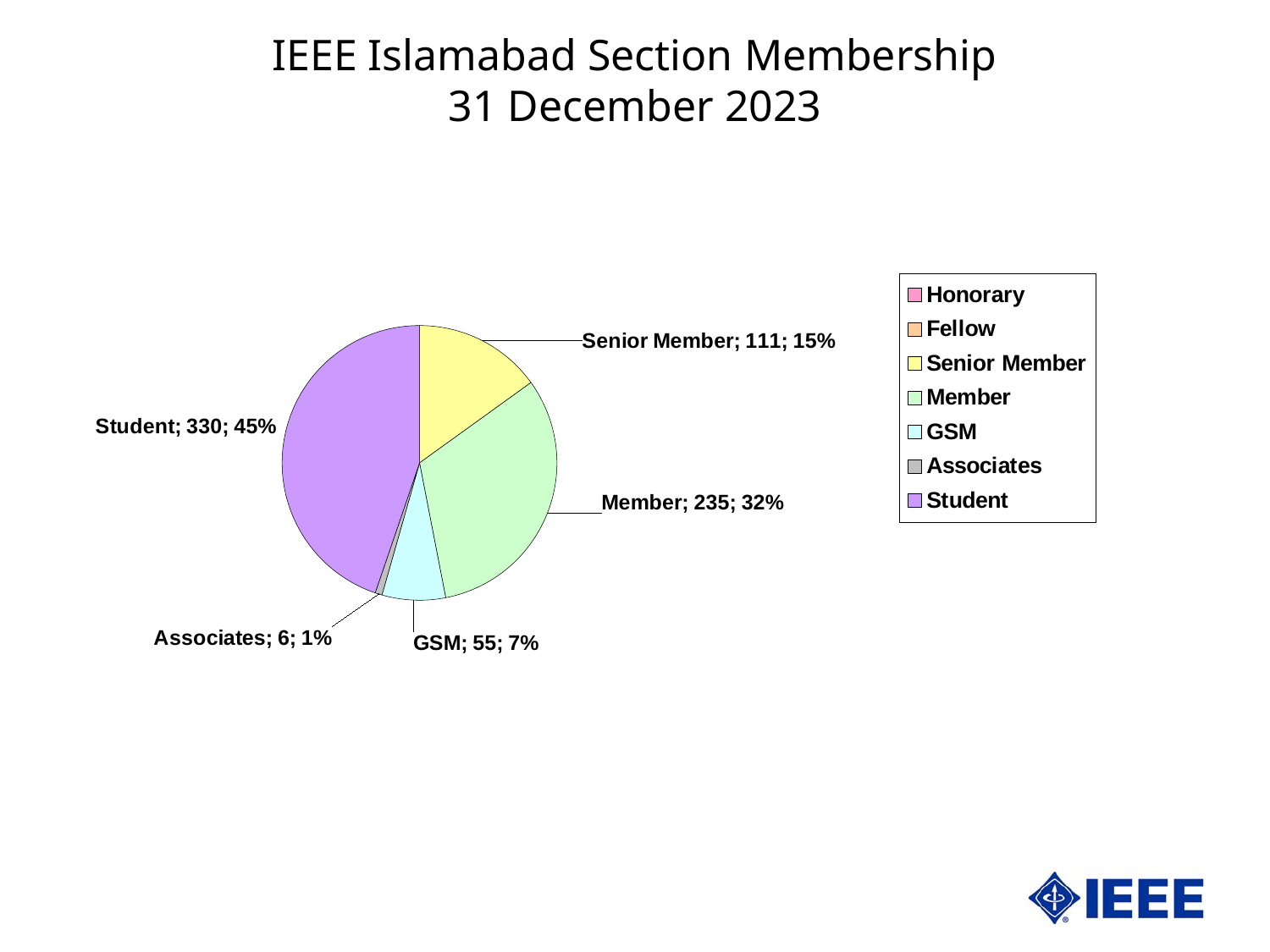
Which has more members, Senior Member or GSM? Senior Member How many members does the Associates slice represent? 6 How many categories does the legend list? 7 Which labelled category has the smallest slice of the pie? Associates How many members does the Senior Member slice represent? 111 Which labelled category has the largest slice of the pie? Student What kind of chart is shown on the slide? pie chart What is the title of the chart on the slide? IEEE Islamabad Section Membership 31 December 2023 What share of the pie does the Member slice represent? 32% What share of the pie does the GSM slice represent? 7% How many members does the Student slice represent? 330 What is the difference in member count between Student and Member? 95